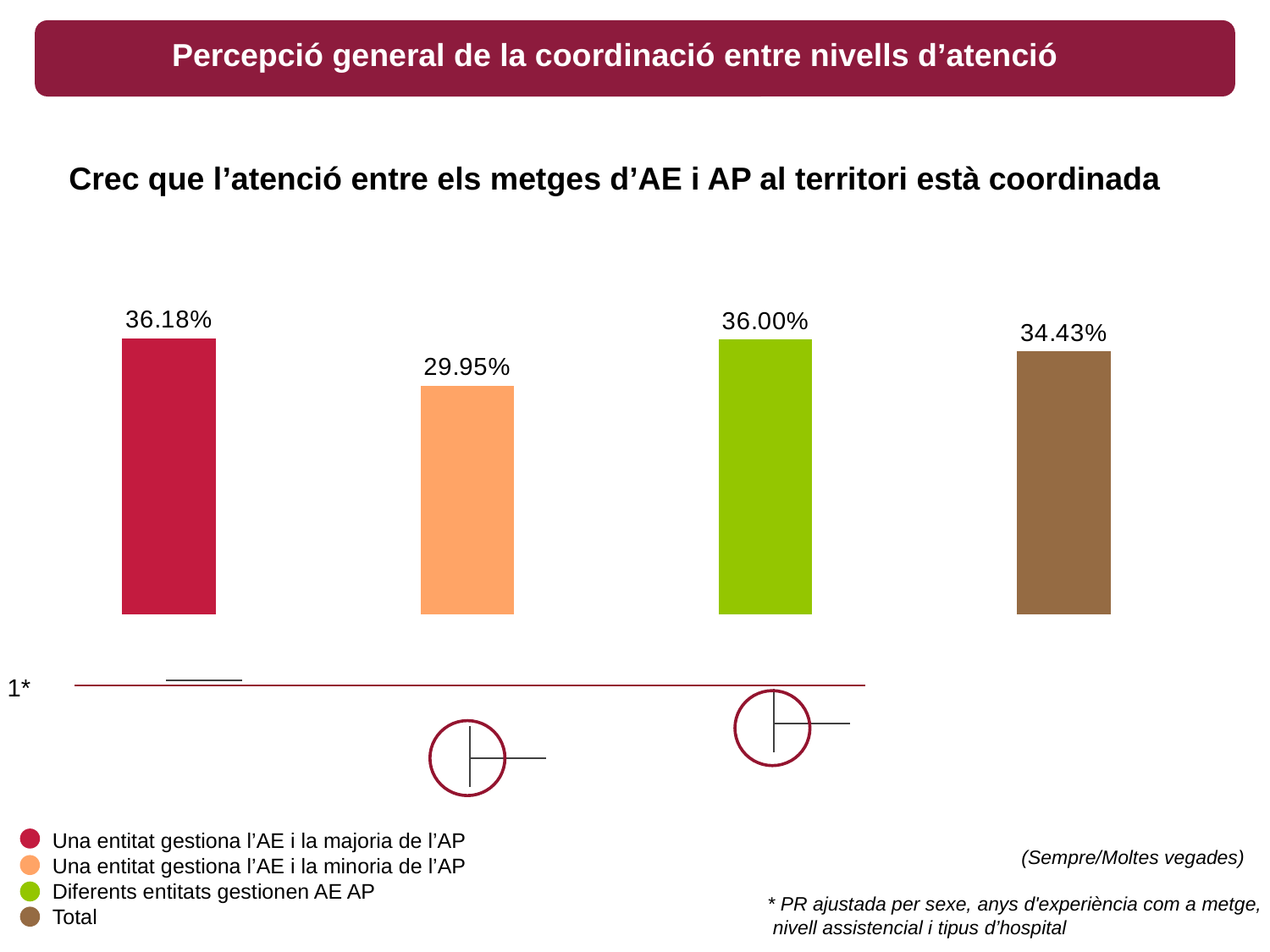
What is the value for 'Una entitat gestiona l'AE i la minoria de l'AP'? 29.95% What is the value for 'Una entitat gestiona l'AE i la majoria de l'AP'? 36.18% What is the value for 'Total'? 34.43% What kind of chart is shown on the slide? Bar chart What is the difference between the values for 'Una entitat gestiona l'AE i la majoria de l'AP' and 'Una entitat gestiona l'AE i la minoria de l'AP'? 6.23% Which is larger, the value for 'Total' or the value for 'Una entitat gestiona l'AE i la minoria de l'AP'? Total What is the value for 'Diferents entitats gestionen AE AP'? 36.00% Which category has the highest value? Una entitat gestiona l'AE i la majoria de l'AP What is the difference between the values for 'Diferents entitats gestionen AE AP' and 'Total'? 1.57% How many entries does the legend list? 4 How many bars are plotted in the chart? 4 Which category has the lowest value? Una entitat gestiona l'AE i la minoria de l'AP